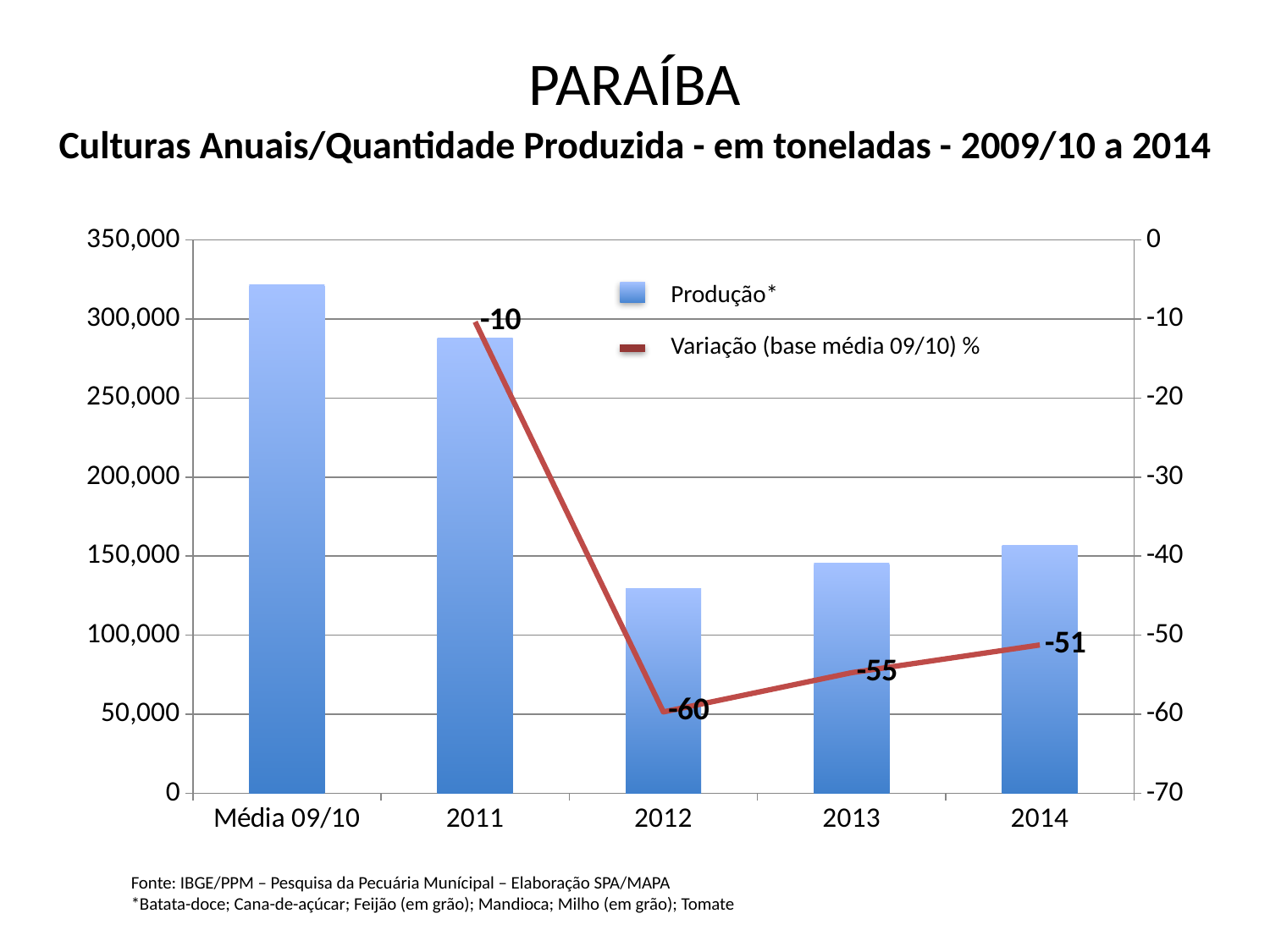
How many categories are shown on the x axis? 5 What is the value of Variação (base média 09/10) % for 2011? -10 What is the value of Variação (base média 09/10) % for 2012? -60 What is the difference between the Variação values for 2013 and 2014? 4 Which series is drawn as a red line? Variação (base média 09/10) % In which year is the Variação (base média 09/10) % lowest? 2012 What kind of chart is shown on the slide? Combined bar and line chart What is the value of Variação (base média 09/10) % for 2014? -51 Which has a higher Produção bar, 2012 or 2014? 2014 Is the Produção value for Média 09/10 greater or less than 300,000? greater Is the Produção value for 2012 greater or less than 150,000? less How many series does the legend list? 2